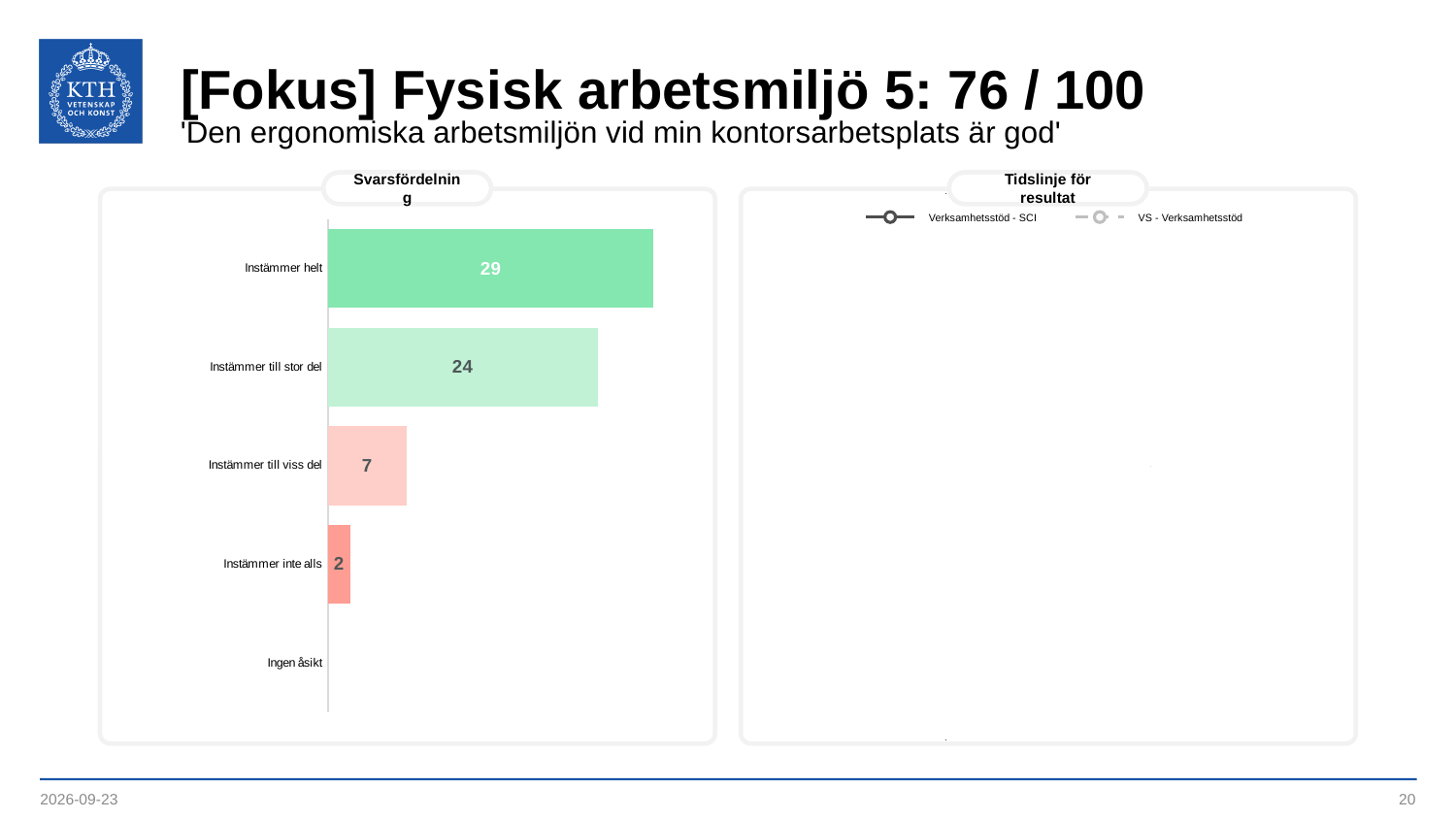
In the Svarsfördelning chart, what is the difference between Instämmer till stor del and Instämmer till viss del? 17 In the Svarsfördelning chart, which category has the highest value? Instämmer helt In the Svarsfördelning chart, what is the value for Instämmer till viss del? 7 In the Svarsfördelning chart, what is the value for Instämmer inte alls? 2 In the Svarsfördelning chart, what is the value for Instämmer till stor del? 24 What kind of chart is the Svarsfördelning chart? bar chart In the Svarsfördelning chart, which is larger: Instämmer till viss del or Instämmer inte alls? Instämmer till viss del In the Svarsfördelning chart, what is the value for Instämmer helt? 29 How many categories are listed in the Svarsfördelning chart? 5 How many series does the legend of the Tidslinje för resultat chart list? 2 In the Svarsfördelning chart, which category has no bar shown? Ingen åsikt In the Svarsfördelning chart, what is the difference between Instämmer helt and Instämmer till stor del? 5